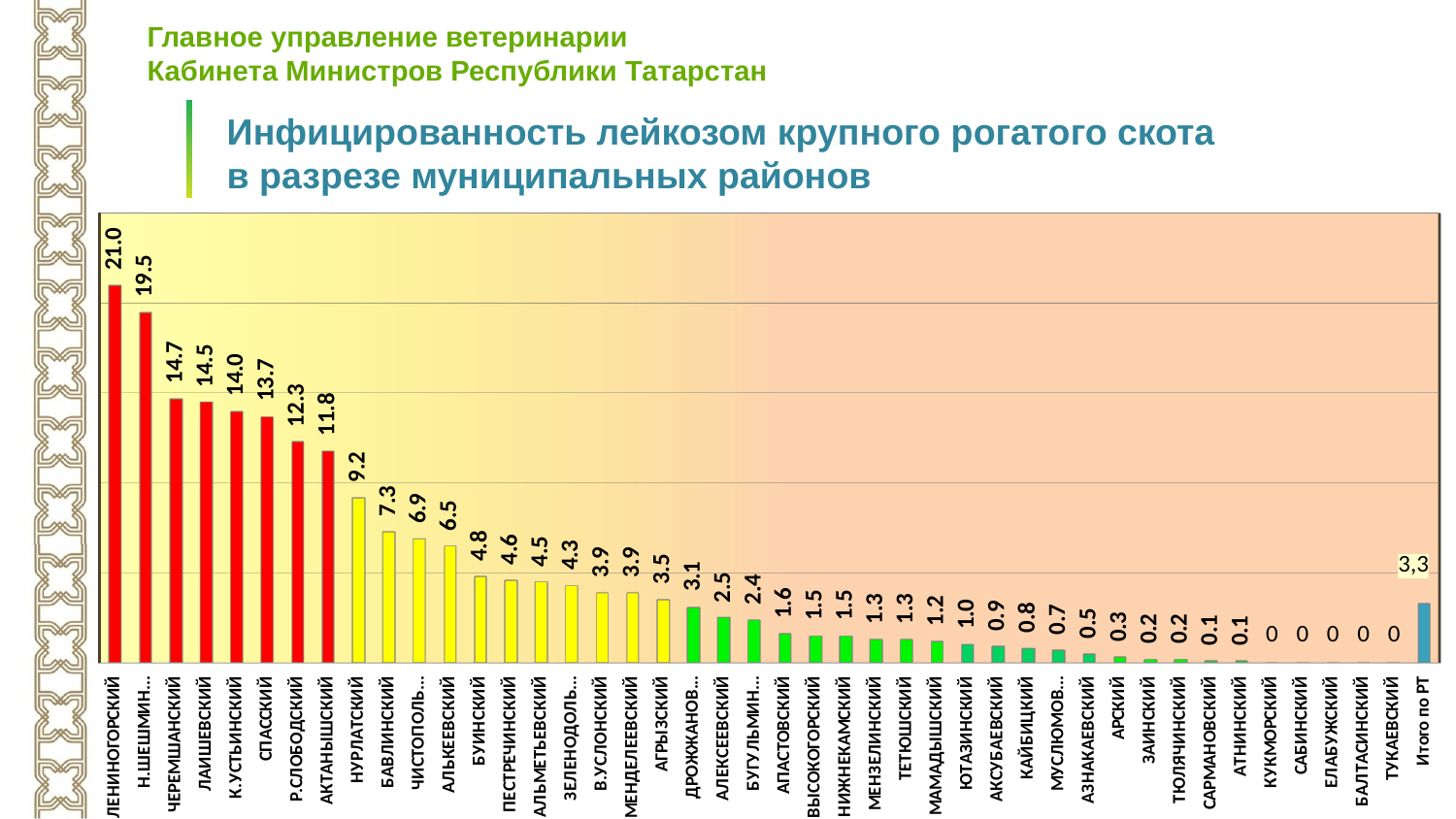
What is the value shown for Итого по РТ? 3,3 What colour are the bars for the districts with the highest values, such as ЛЕНИНОГОРСКИЙ and ЛАИШЕВСКИЙ? Red Which is larger, the value for СПАССКИЙ or the value for Р.СЛОБОДСКИЙ? СПАССКИЙ Do the values rise or fall from left to right across the districts? Fall What is the value for АЛЬКЕЕВСКИЙ? 6.5 What is the value for АЗНАКАЕВСКИЙ? 0.5 What is the value for НУРЛАТСКИЙ? 9.2 Which district has the highest value? ЛЕНИНОГОРСКИЙ How many districts have a value of 0? 5 What is the difference between the values for ЛЕНИНОГОРСКИЙ and ЧЕРЕМШАНСКИЙ? 6.3 What kind of chart is shown on the slide? Bar chart What is the value for ЛЕНИНОГОРСКИЙ? 21.0